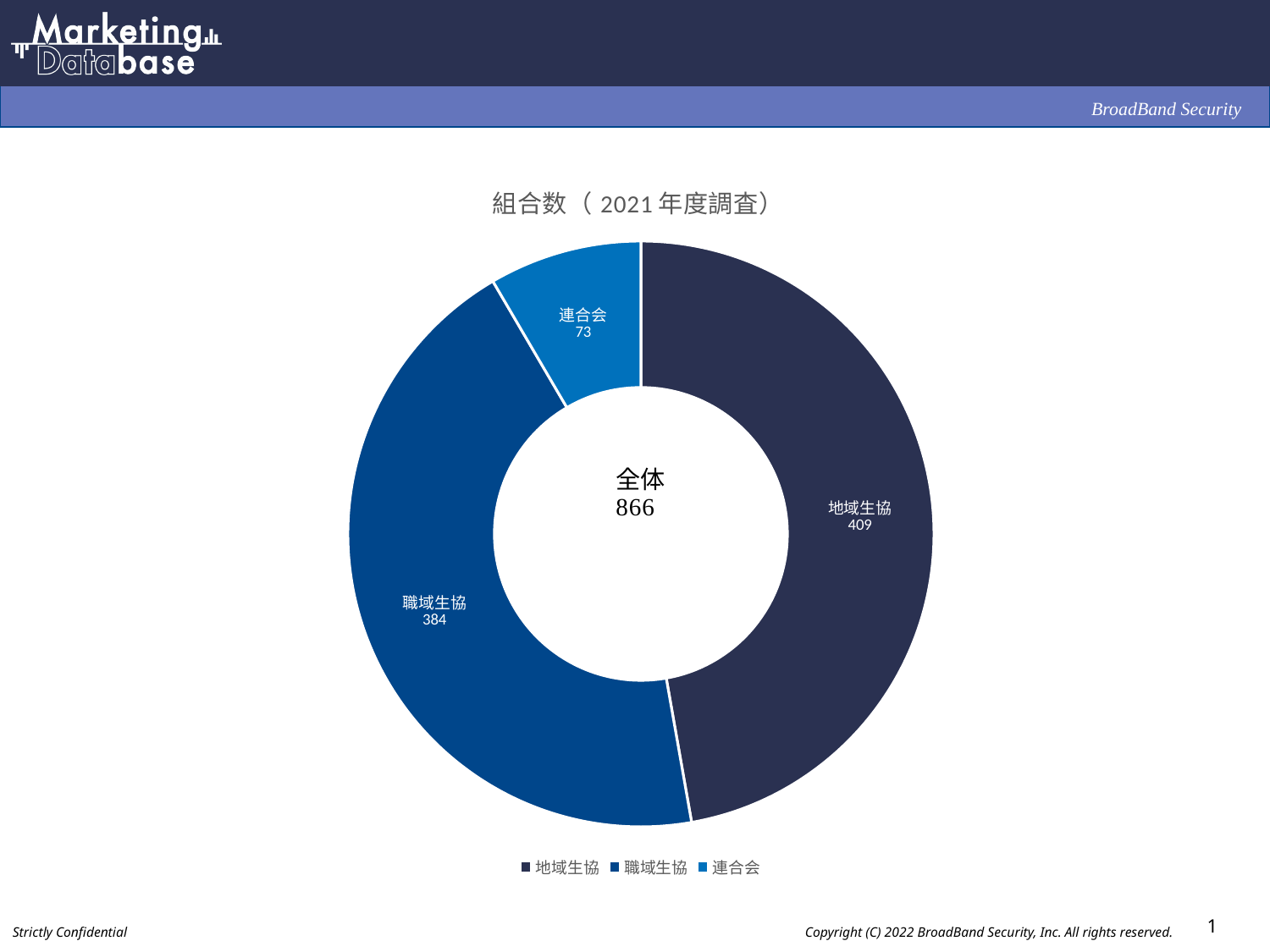
Which category has the smallest slice in the chart? 連合会 What is the difference between the values for 職域生協 and 連合会? 311 Which is larger, the value for 職域生協 or the value for 連合会? 職域生協 What is the value for 職域生協 in the chart? 384 What is the difference between the values for 地域生協 and 職域生協? 25 What is the value for 地域生協 in the chart? 409 How many categories are shown in the chart? 3 Which category has the largest slice in the chart? 地域生協 What is the value for 連合会 in the chart? 73 What kind of chart is shown on the slide? Doughnut (pie) chart What total value is shown in the centre of the chart? 866 What is the title of the chart? 組合数（2021年度調査）